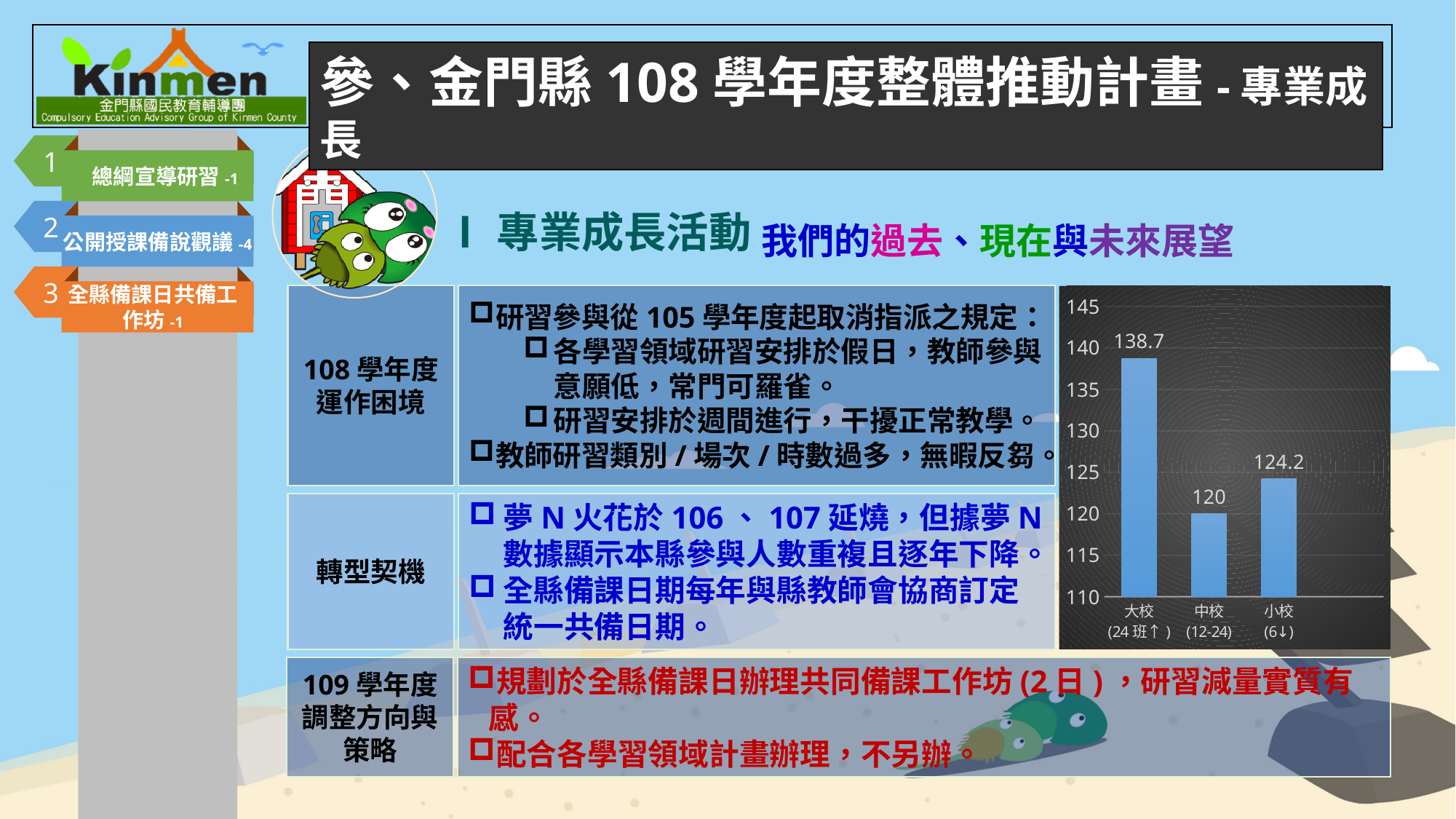
Which category has the highest value in the bar chart? 大校 (24班↑) What is the difference between the values for 大校 (24班↑) and 中校 (12-24)? 18.7 What is the lowest value shown on the vertical axis of the bar chart? 110 What is the value for 中校 (12-24) in the bar chart? 120 How many categories are shown in the bar chart? 3 Which category has the lowest value in the bar chart? 中校 (12-24) What is the value for 大校 (24班↑) in the bar chart? 138.7 Which is larger, the value for 小校 (6↓) or the value for 中校 (12-24)? 小校 (6↓) Is the value for 大校 (24班↑) greater or less than 135? greater What is the difference between the values for 小校 (6↓) and 中校 (12-24)? 4.2 What kind of chart is shown on the slide? bar chart What is the value for 小校 (6↓) in the bar chart? 124.2